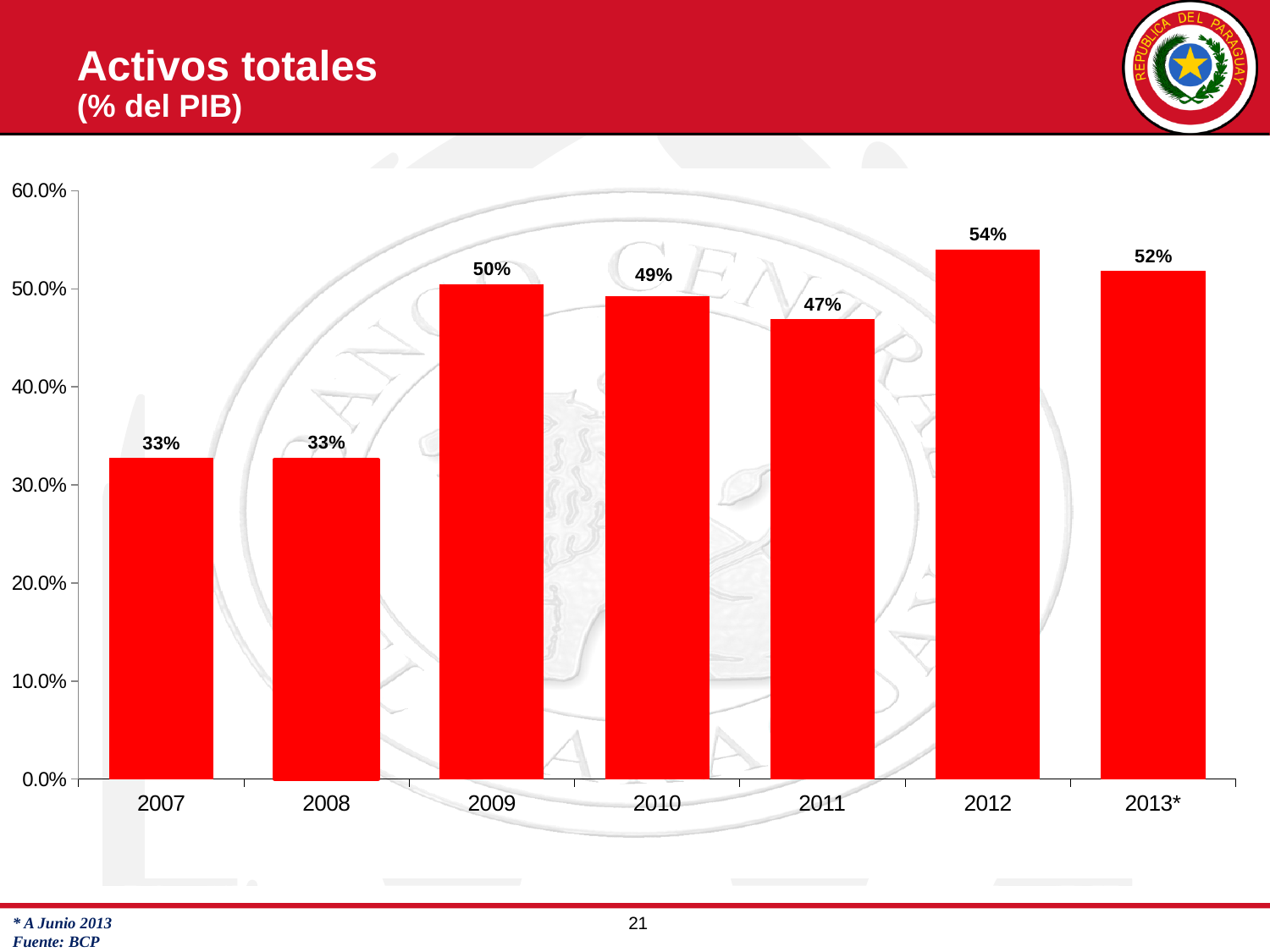
What is the value for 2009? 50% What kind of chart is shown on the slide? bar chart What is the value for 2013*? 52% Is the value for 2008 greater or less than 40.0%? less What is the title of the chart? Activos totales (% del PIB) What is the difference between the values for 2009 and 2011? 3% Which year has the highest value? 2012 What is the difference between the values for 2012 and 2007? 21% How many years are shown on the x axis? 7 Do the values generally rise or fall from 2007 to 2012? rise What is the value for 2011? 47% Which is larger, the value for 2010 or the value for 2011? 2010